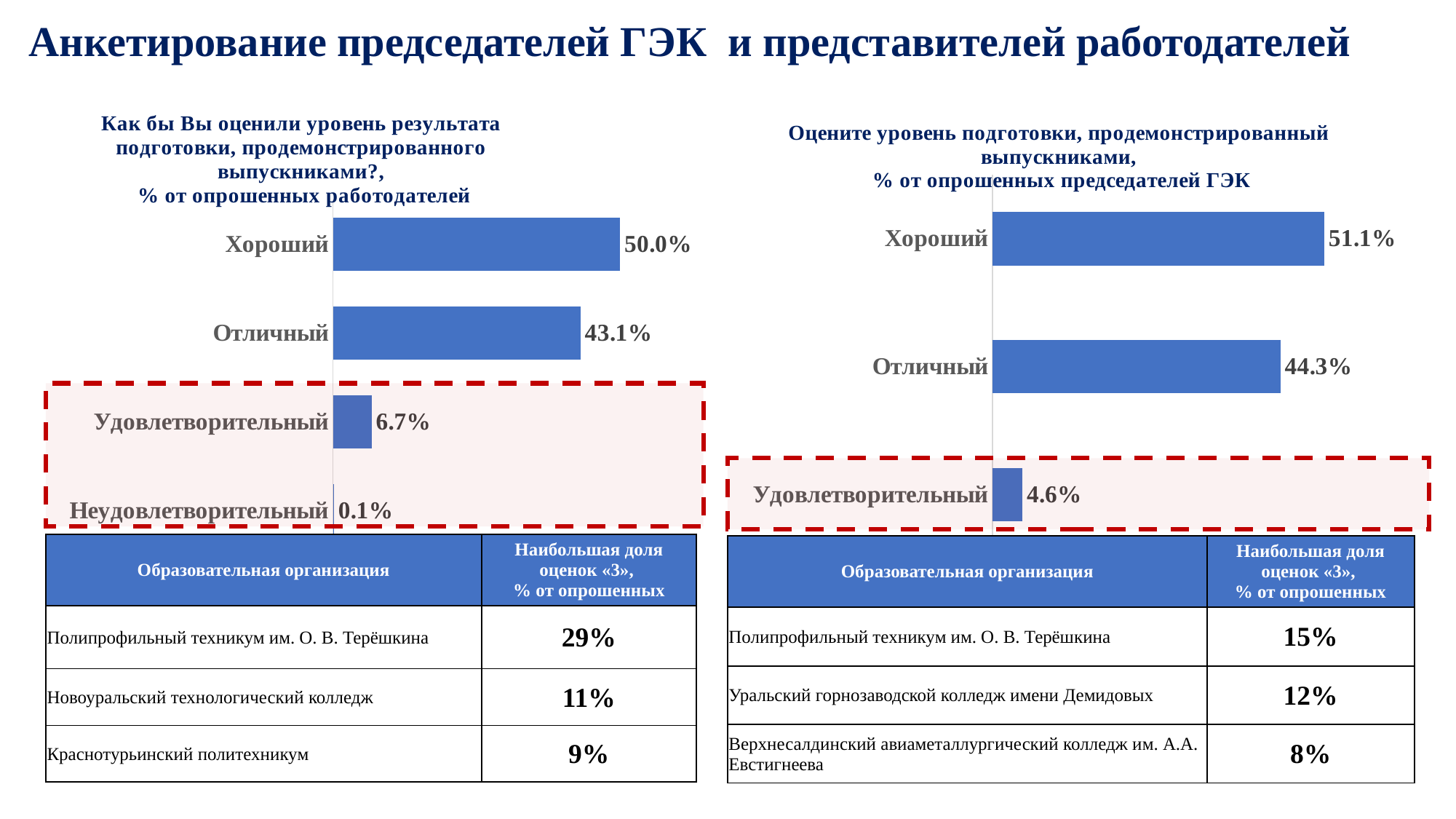
In the right chart (% of surveyed ГЭК chairs), which category has the lowest value? Удовлетворительный In the left chart (% of surveyed employers), what is the value for «Неудовлетворительный»? 0.1% How many categories are shown in the left chart (% of surveyed employers)? 4 In the right chart (% of surveyed ГЭК chairs), what is the value for «Удовлетворительный»? 4.6% In the right chart (% of surveyed ГЭК chairs), what is the value for «Отличный»? 44.3% In the left chart (% of surveyed employers), what is the difference between «Хороший» and «Отличный»? 6.9% In the left chart (% of surveyed employers), which category has the highest value? Хороший How many categories are shown in the right chart (% of surveyed ГЭК chairs)? 3 In the left chart (% of surveyed employers), what is the value for «Хороший»? 50.0% Which is larger: «Удовлетворительный» in the left chart or «Удовлетворительный» in the right chart? Left chart (6.7%) What type of chart is used on the right side of the slide? Bar chart In the right chart (% of surveyed ГЭК chairs), what is the difference between «Хороший» and «Удовлетворительный»? 46.5%